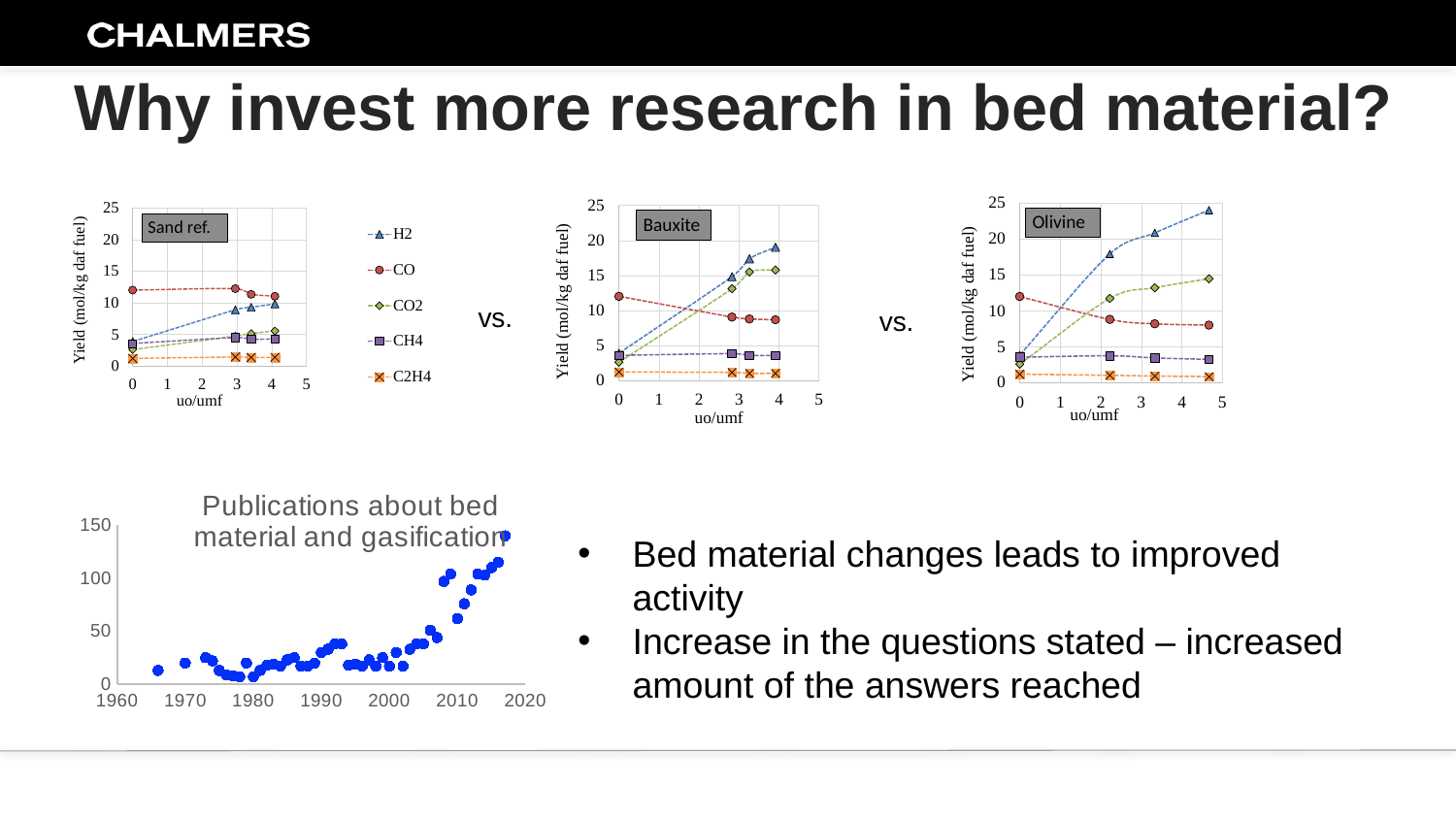
In the Sand ref. chart, how many series does the legend list? 5 In the Bauxite chart, does the CO yield rise or fall as uo/umf increases? fall In the Olivine chart, is the H2 yield at the rightmost point greater or less than 20? greater In the Bauxite chart, is the H2 yield at the rightmost point greater or less than 15? greater In the 'Publications about bed material and gasification' chart, do the values generally rise or fall from 1960 to 2020? rise In the Sand ref. chart, what is the label of the y axis? Yield (mol/kg daf fuel) What kind of chart is the 'Publications about bed material and gasification' chart? scatter chart In the Sand ref. chart, which series has the highest yield at uo/umf = 0? CO In the Olivine chart, which series has the lowest yield at the rightmost point? C2H4 In the Sand ref. chart, does the H2 yield rise or fall as uo/umf increases? rise In the Bauxite chart, which is larger at the rightmost point, the H2 yield or the CO yield? H2 In the 'Publications about bed material and gasification' chart, is the highest point greater or less than 100? greater